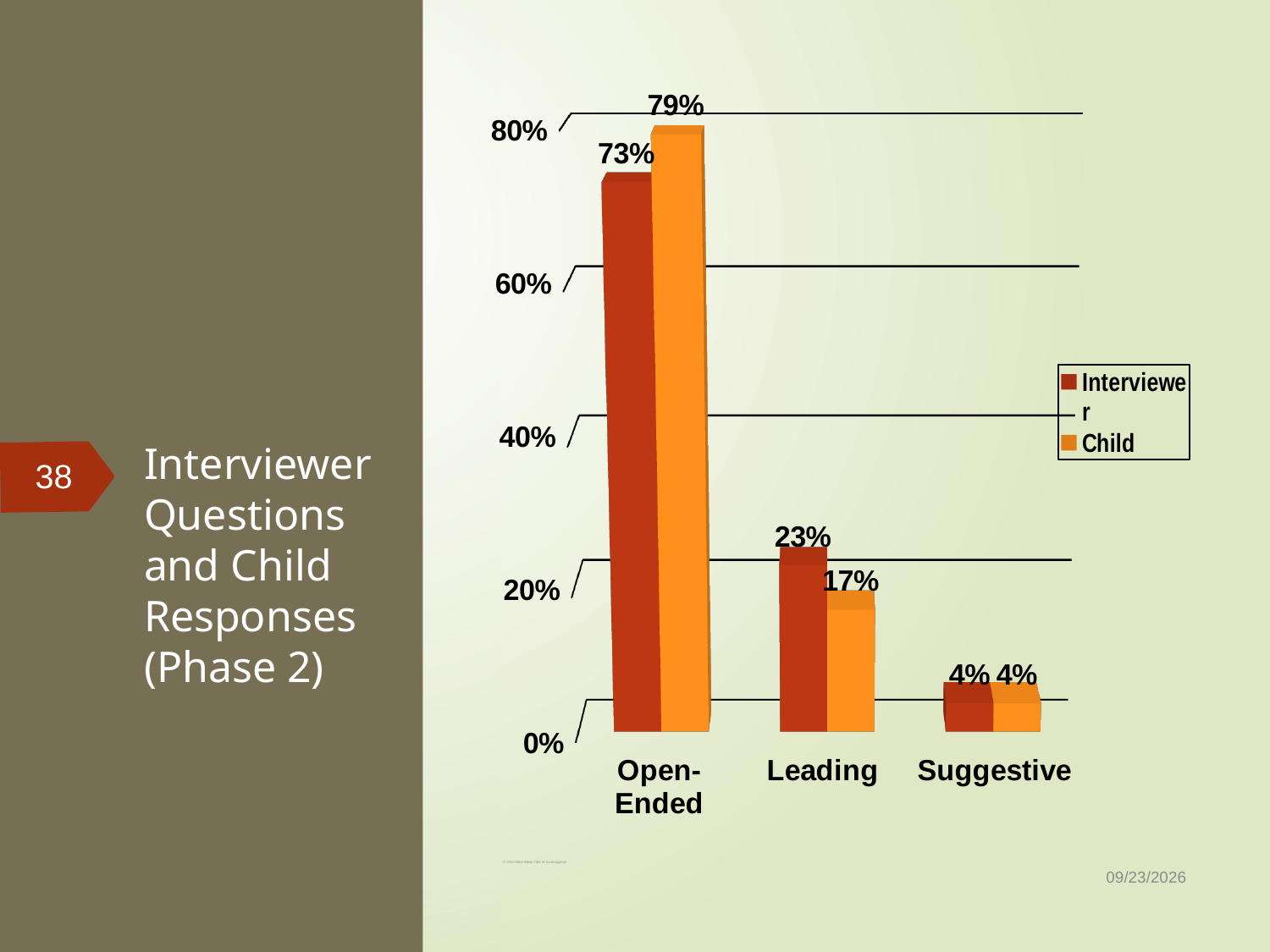
Do the Child values rise or fall from Open-Ended to Suggestive? Fall How many series does the legend list? 2 What is the Child value for Open-Ended? 79% What kind of chart is shown on the slide? Bar chart What is the Interviewer value for Leading? 23% What is the Interviewer value for Open-Ended? 73% What is the difference between the Interviewer and Child values for Leading? 6% What is the Child value for Suggestive? 4% Which category has the lowest Interviewer value? Suggestive For Open-Ended, which is larger, the Interviewer value or the Child value? Child How many categories are shown on the x axis? 3 Which category has the highest Child value? Open-Ended